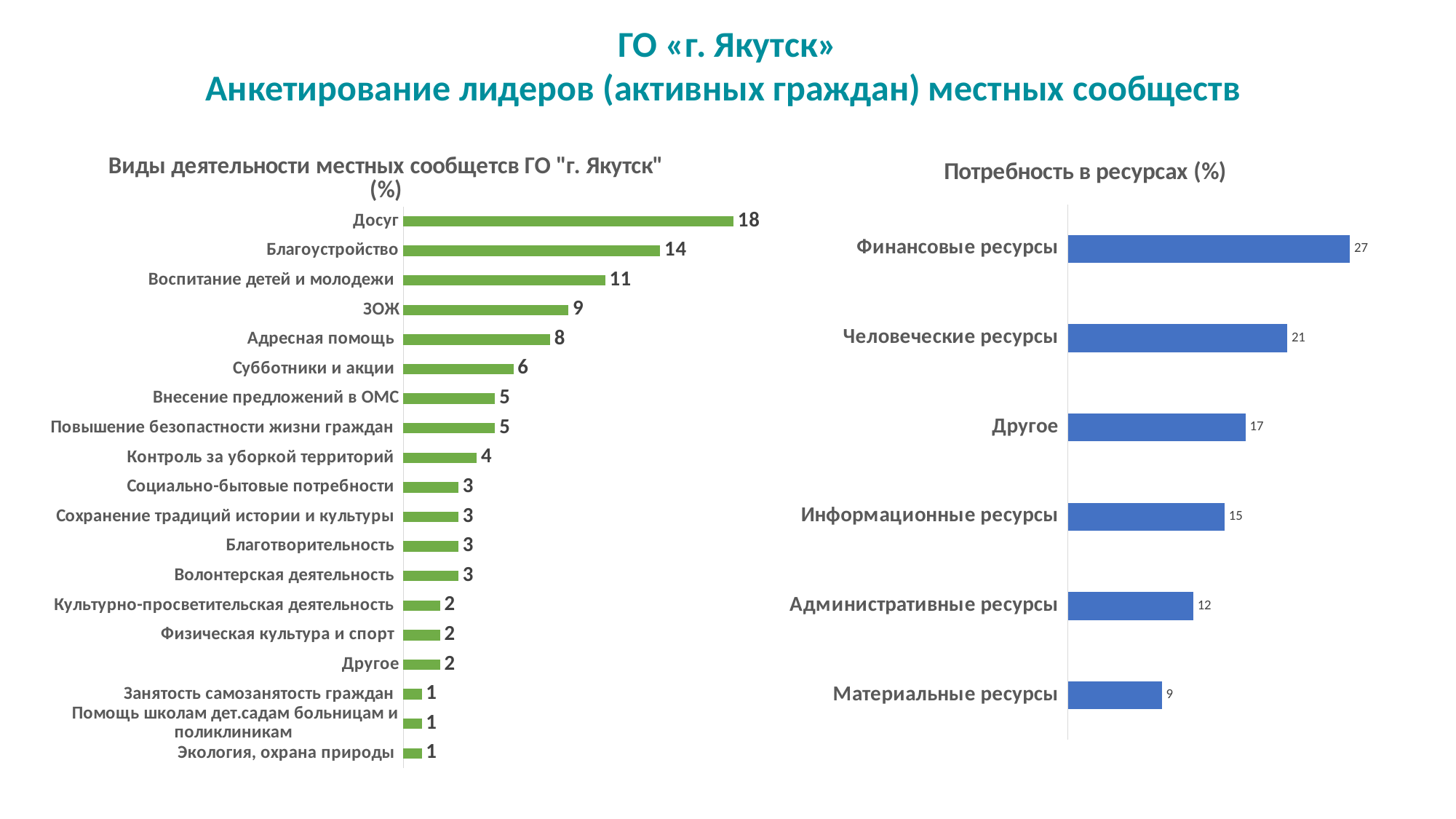
What type of chart is the chart on the left of the slide? Bar chart In the chart "Потребность в ресурсах (%)", what is the value for Финансовые ресурсы? 27 What colour are the bars in the chart "Потребность в ресурсах (%)"? Blue In the chart "Виды деятельности местных сообщетсв ГО "г. Якутск" (%)", which category has the highest value? Досуг In the chart "Виды деятельности местных сообщетсв ГО "г. Якутск" (%)", what is the value for Благоустройство? 14 In the chart "Виды деятельности местных сообщетсв ГО "г. Якутск" (%)", what is the difference between Досуг and ЗОЖ? 9 In the chart "Виды деятельности местных сообщетсв ГО "г. Якутск" (%)", how many categories are shown? 19 In the chart "Потребность в ресурсах (%)", which category has the lowest value? Материальные ресурсы In the chart "Потребность в ресурсах (%)", which is larger: Другое or Административные ресурсы? Другое In the chart "Потребность в ресурсах (%)", what is the difference between Человеческие ресурсы and Информационные ресурсы? 6 In the chart "Потребность в ресурсах (%)", how many categories are shown? 6 In the chart "Виды деятельности местных сообщетсв ГО "г. Якутск" (%)", what is the value for Адресная помощь? 8